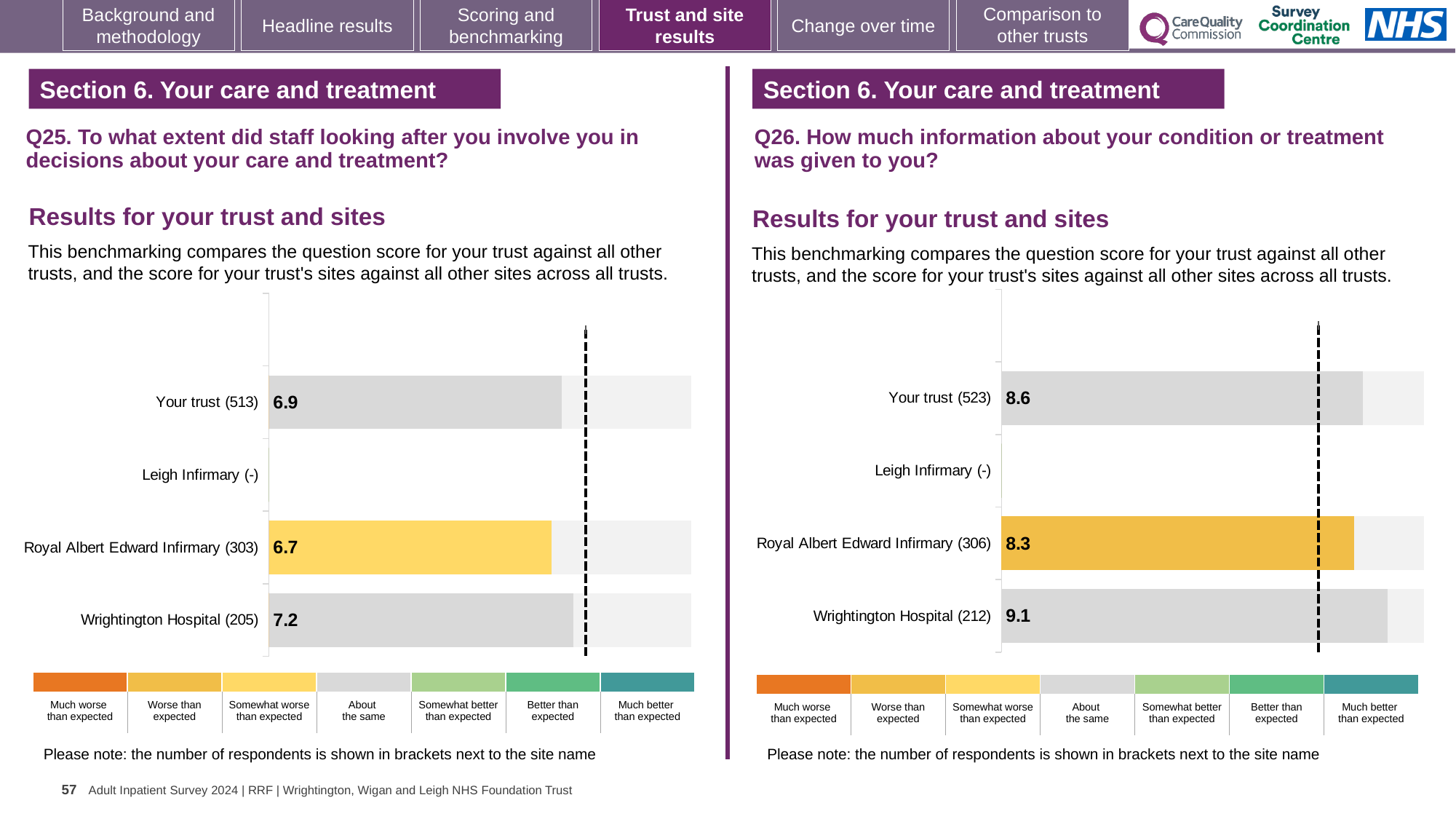
On the Q25 chart (left), what is the difference between the scores for Wrightington Hospital and Royal Albert Edward Infirmary? 0.5 On the Q26 chart (right), which is larger: the score for Your trust or the score for Royal Albert Edward Infirmary? Your trust On the Q26 chart (right), how many respondents are shown in brackets for Royal Albert Edward Infirmary? 306 On the Q25 chart (left), which site or trust row has the highest score? Wrightington Hospital On the Q25 chart (left), how many respondents are shown in brackets for Your trust? 513 On the Q26 chart (right), what is the score for Wrightington Hospital? 9.1 On the Q25 chart (left), which row has no bar plotted? Leigh Infirmary On the Q26 chart (right), which row has the lowest score among those with a bar? Royal Albert Edward Infirmary On the Q26 chart (right), what is the difference between the scores for Wrightington Hospital and Your trust? 0.5 On the Q25 chart (left), what is the score for Your trust? 6.9 What kind of chart is used on the Q25 chart (left)? Bar chart On the Q25 chart (left), what is the score for Royal Albert Edward Infirmary? 6.7